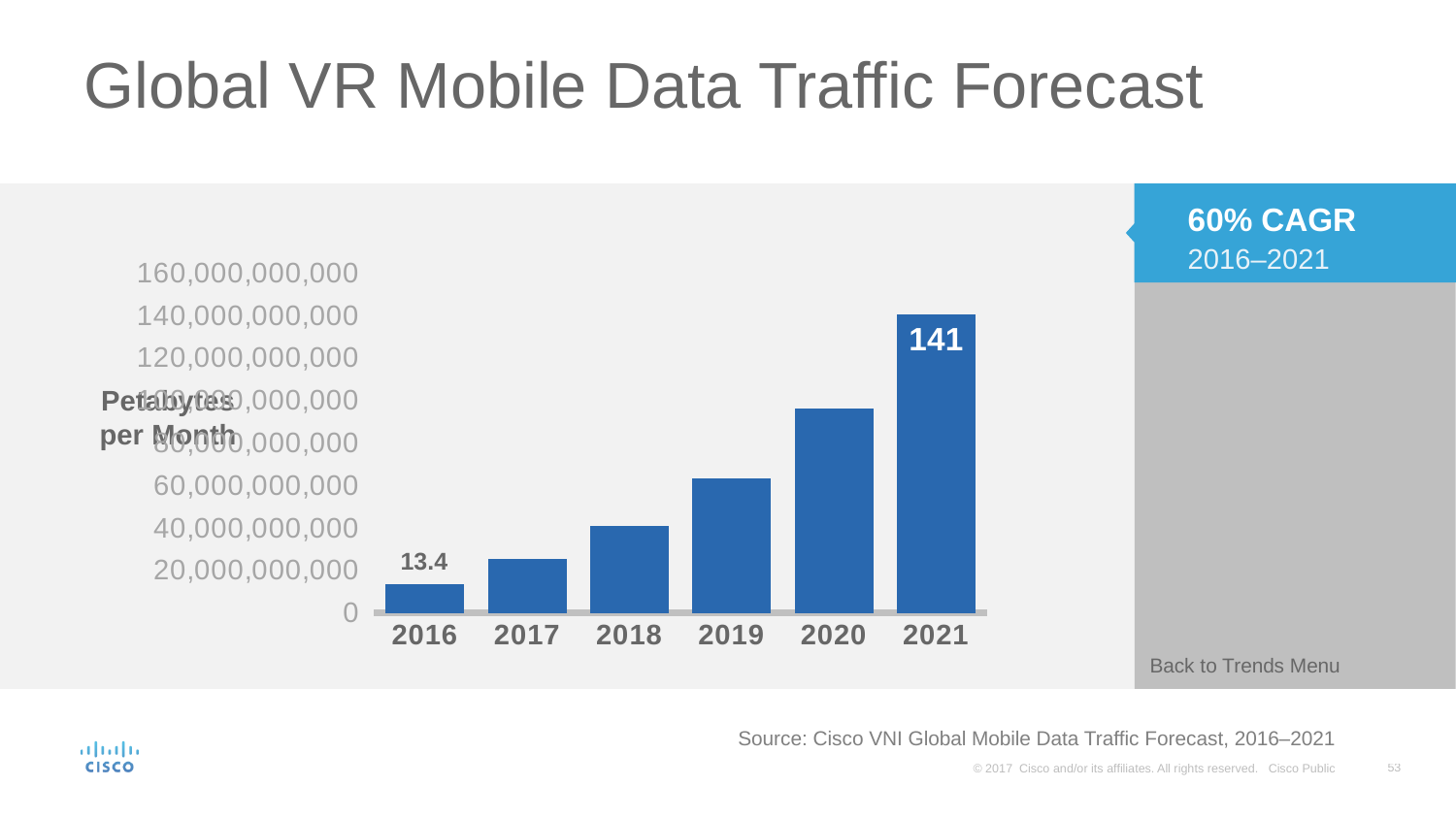
Which year has the lowest bar? 2016 What CAGR is stated for 2016–2021 on the slide? 60% CAGR How many years are shown on the x axis? 6 Is the value for 2020 greater or less than 80,000,000,000 on the axis? greater What is the value shown for 2021? 141 Which year has the larger value, 2019 or 2020? 2020 What is the difference between the labelled values for 2021 and 2016? 127.6 What is the value shown for 2016? 13.4 What kind of chart is shown on the slide? Bar chart Is the value for 2017 greater or less than 40,000,000,000 on the axis? less Do the values rise or fall from 2016 to 2021? Rise Which year has the highest bar? 2021